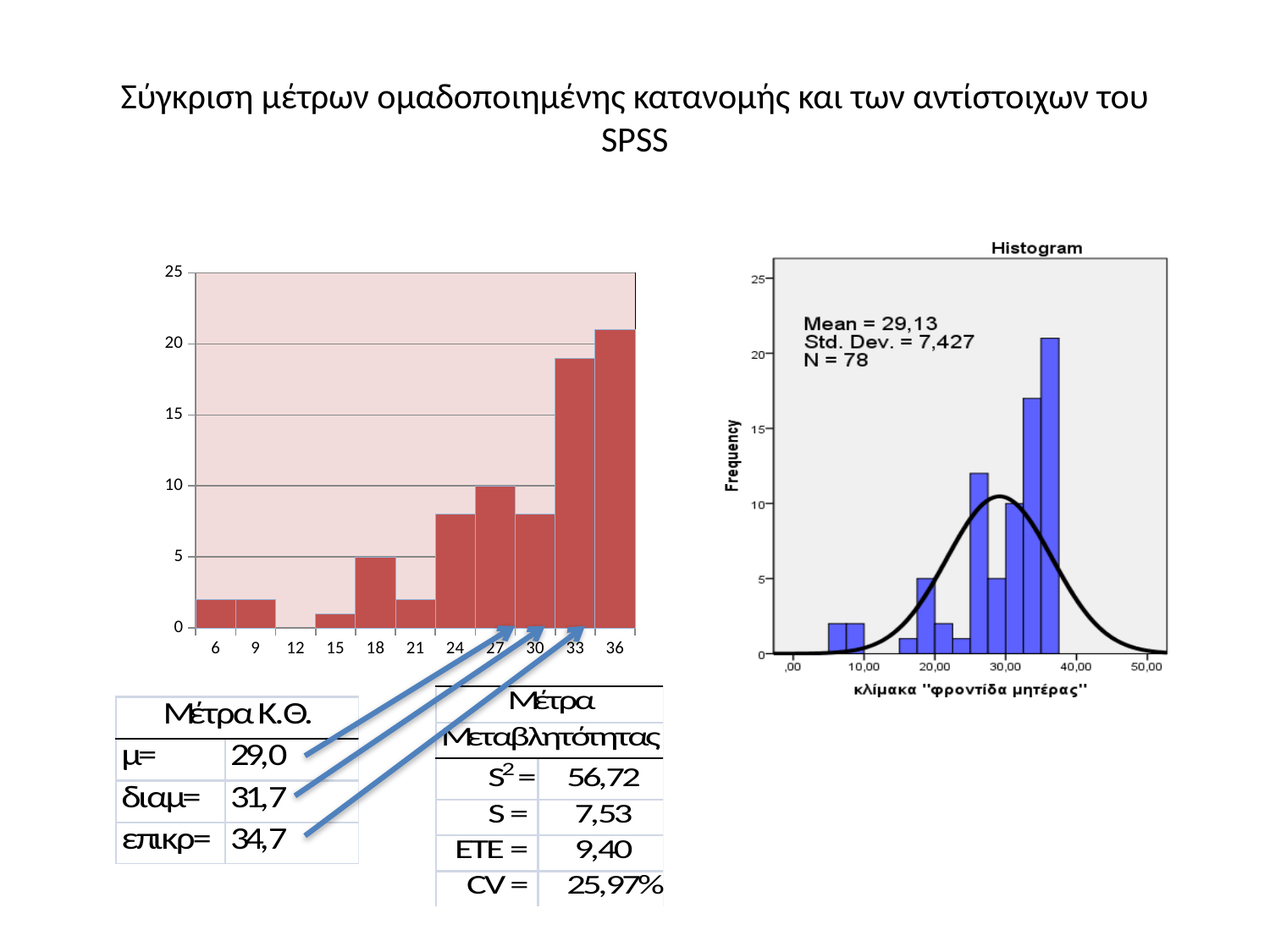
In the right SPSS histogram, is the tallest bar greater or less than 20? greater In the left bar chart, which x-axis category has the highest bar? 36 In the left bar chart, which is larger, the value for 33 or the value for 30? 33 What kind of chart is the left chart with the red bars? bar chart What Mean value is printed on the right SPSS histogram? 29,13 In the left bar chart, which x-axis category has the lowest bar? 15 How many x-axis categories are labelled in the left bar chart? 11 In the left bar chart, what is the value for category 18? 5 In the left bar chart, do the values generally rise or fall from left to right along the x axis? rise In the left bar chart, what is the value for category 27? 10 In the left bar chart, is the value for category 33 greater or less than 15? greater In the left bar chart, is the value for category 24 greater or less than 10? less